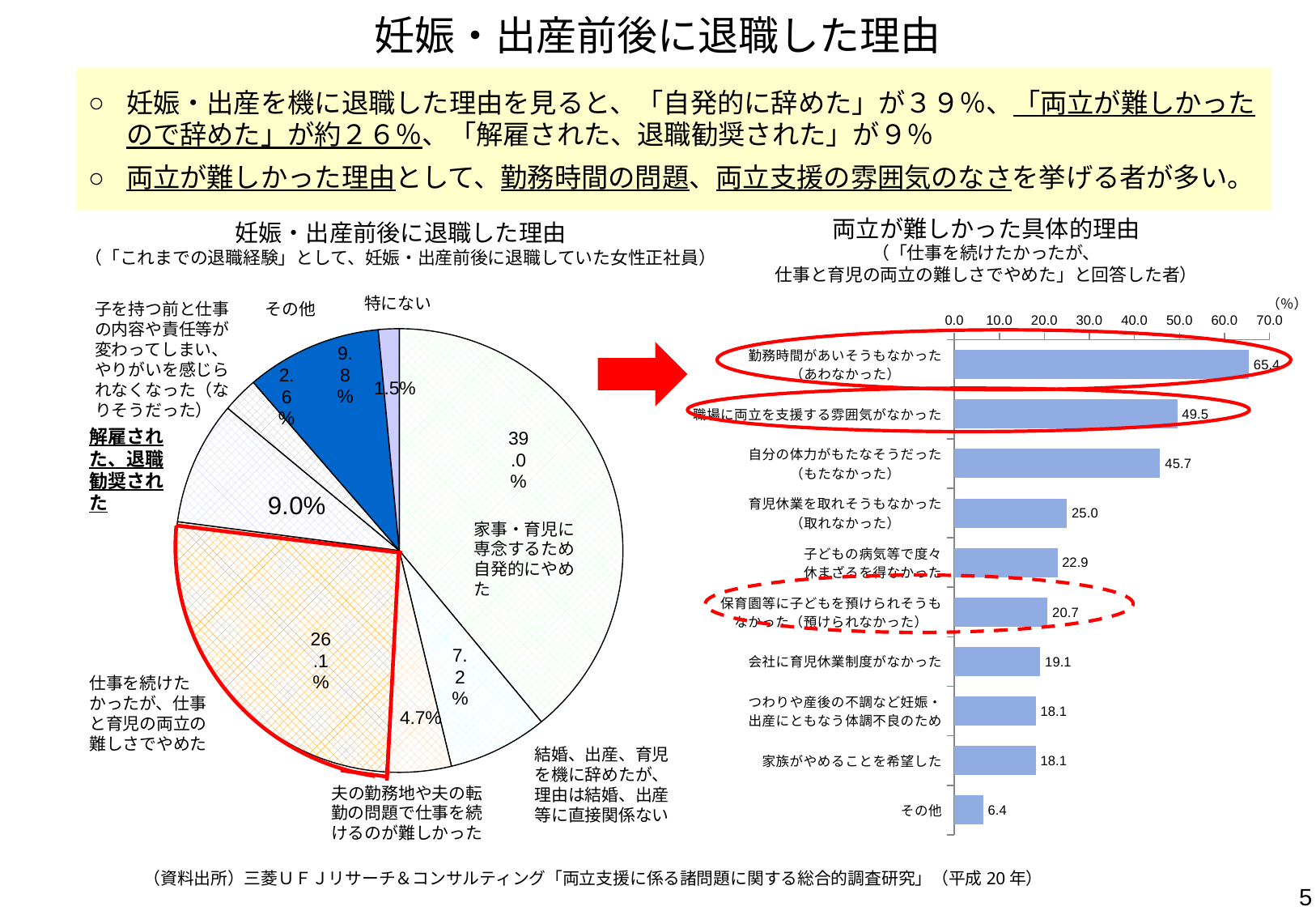
In the bar chart titled 両立が難しかった具体的理由, which category has the highest value? 勤務時間があいそうもなかった（あわなかった） In the bar chart titled 両立が難しかった具体的理由, which category has the lowest value? その他 In the bar chart titled 両立が難しかった具体的理由, what is the value for 育児休業を取れそうもなかった（取れなかった）? 25.0 In the pie chart titled 妊娠・出産前後に退職した理由, what is the share for 仕事を続けたかったが、仕事と育児の両立の難しさでやめた? 26.1% In the bar chart titled 両立が難しかった具体的理由, what is the value for 勤務時間があいそうもなかった（あわなかった）? 65.4 In the bar chart titled 両立が難しかった具体的理由, how many categories are shown? 10 In the pie chart titled 妊娠・出産前後に退職した理由, what is the share for 解雇された、退職勧奨された? 9.0% In the bar chart titled 両立が難しかった具体的理由, which is larger: 自分の体力がもたなそうだった（もたなかった） or 子どもの病気等で度々休まざるを得なかった? 自分の体力がもたなそうだった（もたなかった） What kind of chart is the chart on the right titled 両立が難しかった具体的理由? bar chart In the pie chart titled 妊娠・出産前後に退職した理由, which slice is the largest? 家事・育児に専念するため自発的にやめた In the bar chart titled 両立が難しかった具体的理由, what is the difference between 勤務時間があいそうもなかった（あわなかった） and 職場に両立を支援する雰囲気がなかった? 15.9 In the pie chart titled 妊娠・出産前後に退職した理由, how many slices are there? 8